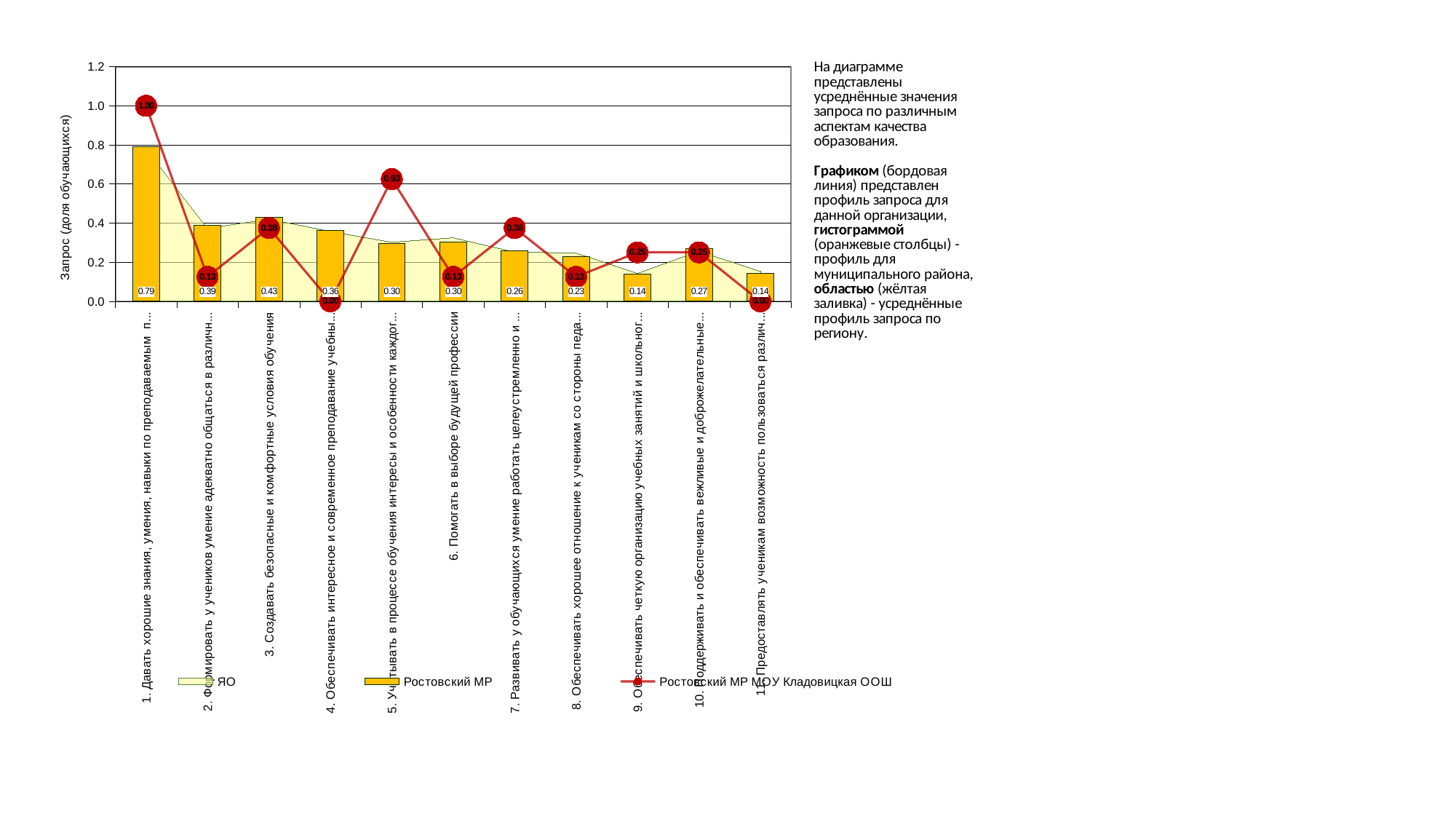
What is the value of the Ростовский МР bar for category 3 (Создавать безопасные и комфортные условия обучения)? 0.43 Which category has the highest value on the Ростовский МР МОУ Кладовицкая ООШ line? Category 1 (1.00) Which category has the highest Ростовский МР bar value? Category 1 (0.79) For category 5, which is larger: the Ростовский МР bar or the Ростовский МР МОУ Кладовицкая ООШ line value? The Ростовский МР МОУ Кладовицкая ООШ line (0.63) Do the Ростовский МР bar values generally rise or fall from category 1 to category 11? fall What is the value of the Ростовский МР МОУ Кладовицкая ООШ line for category 6 (Помогать в выборе будущей профессии)? 0.13 How many categories are shown on the x axis? 11 What is the lowest value shown on the Ростовский МР МОУ Кладовицкая ООШ line? 0.00 How many series does the legend list? 3 For category 1, what is the difference between the Ростовский МР МОУ Кладовицкая ООШ line value and the Ростовский МР bar value? 0.21 What is the value of the Ростовский МР bar for category 6 (Помогать в выборе будущей профессии)? 0.30 Is the ЯО area value for category 1 greater or less than 0.4? greater